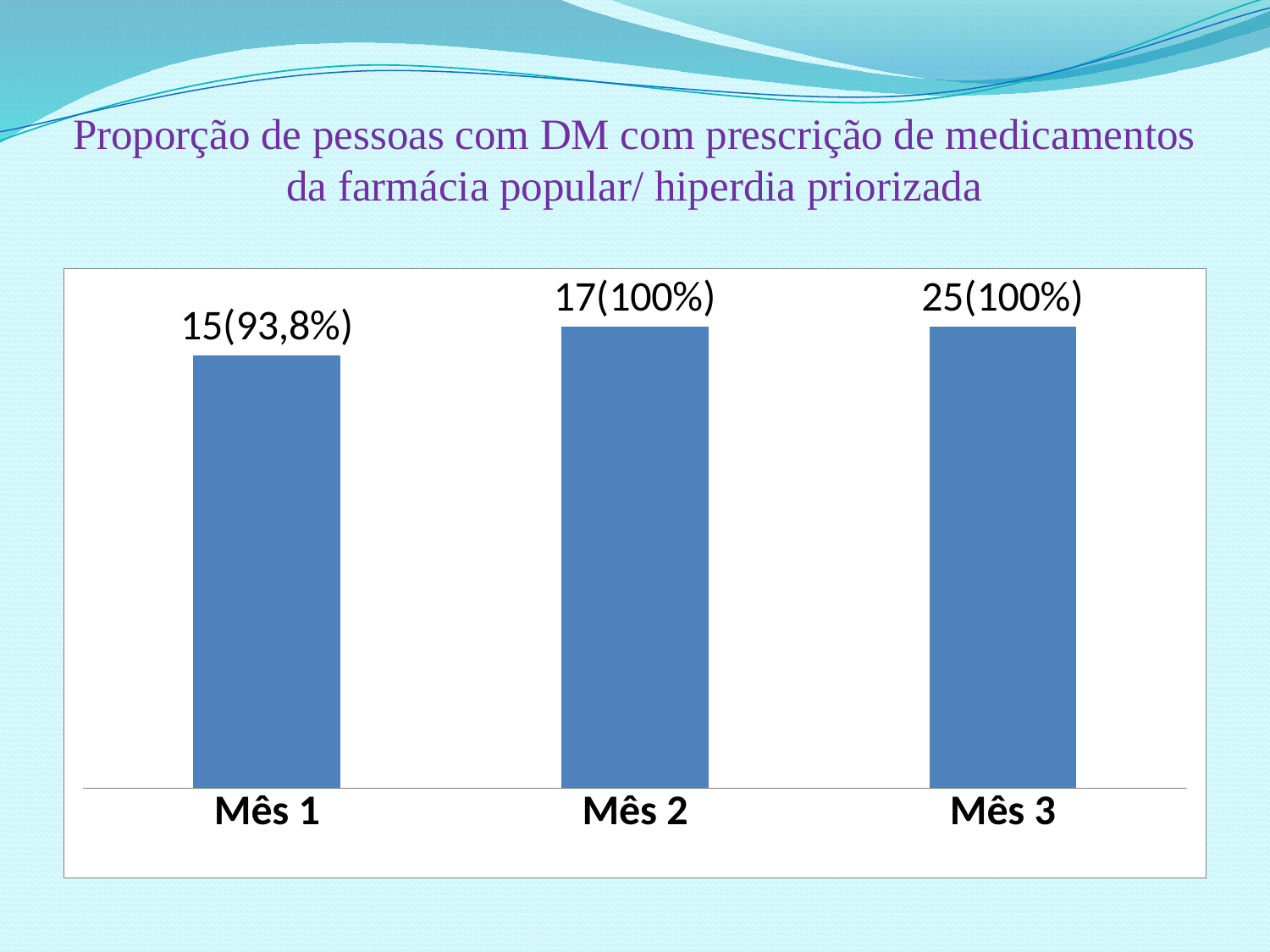
How many months (categories) are shown on the x axis? 3 What is the difference in percentage points between Mês 2 and Mês 1? 6,2 What is the title of the slide above the chart? Proporção de pessoas com DM com prescrição de medicamentos da farmácia popular/ hiperdia priorizada What kind of chart is shown on the slide? Bar chart What percentage is shown for Mês 1? 93,8% Is the bar for Mês 1 shorter or taller than the bar for Mês 2? Shorter What is the data label shown for Mês 2? 17(100%) What is the data label shown for Mês 3? 25(100%) What is the data label shown for Mês 1? 15(93,8%) Which month has the lowest percentage? Mês 1 Does the percentage rise or fall from Mês 1 to Mês 2? Rise How many more people are counted in Mês 3 than in Mês 2? 8